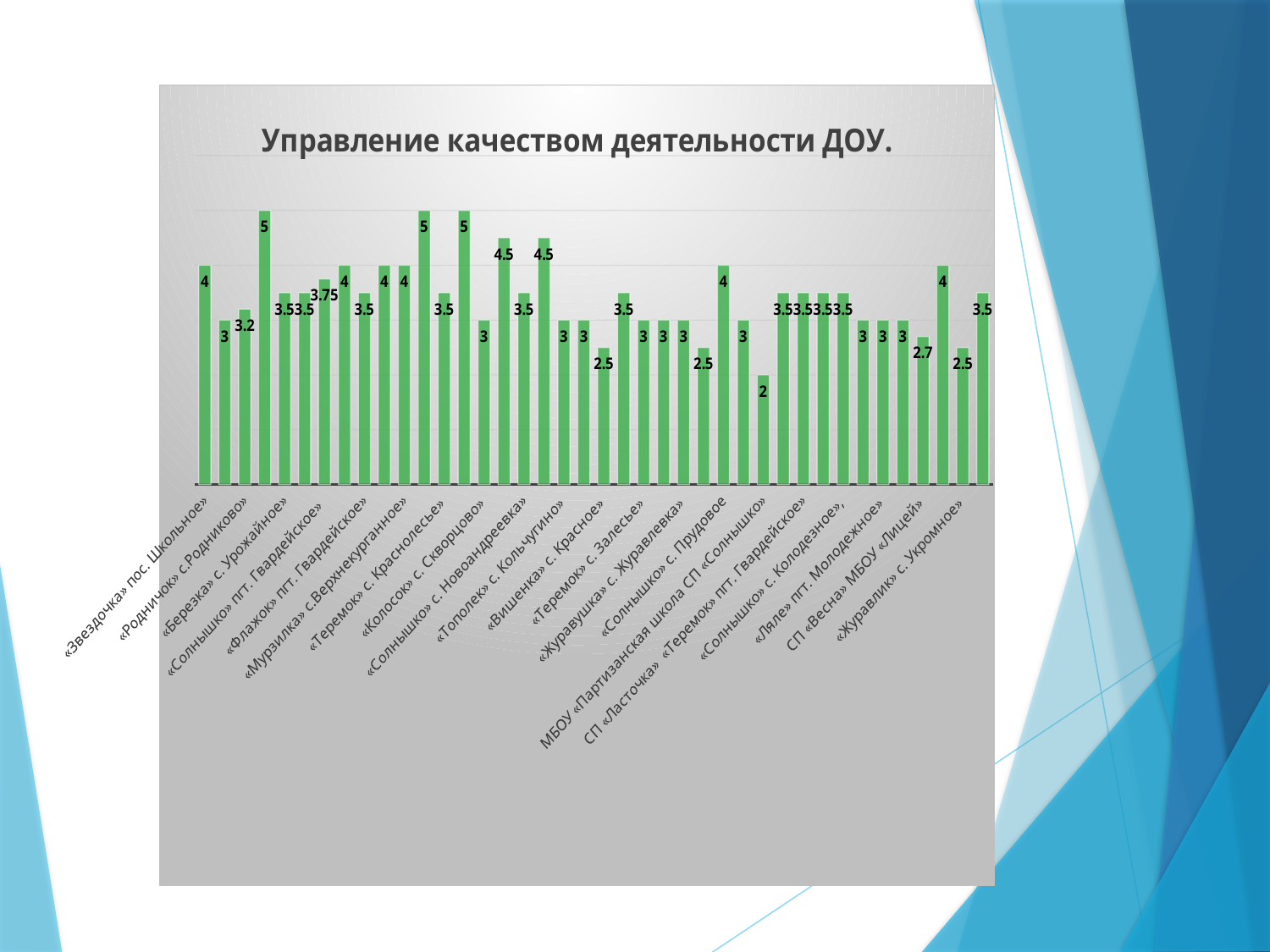
What is the highest value shown on the chart? 5 What is the lowest value shown on the chart? 2 How many bars are plotted on the chart? 40 What kind of chart is shown on the slide? bar chart Is the value for «Звездочка» пос. Школьное greater or less than 3? greater What is the title of the chart? Управление качеством деятельности ДОУ. How many bars have the value 2.5? 3 What is the value for «Звездочка» пос. Школьное? 4 What colour are the bars on the chart? green How many bars reach the value 5? 3 What is the difference between the highest and lowest values on the chart? 3